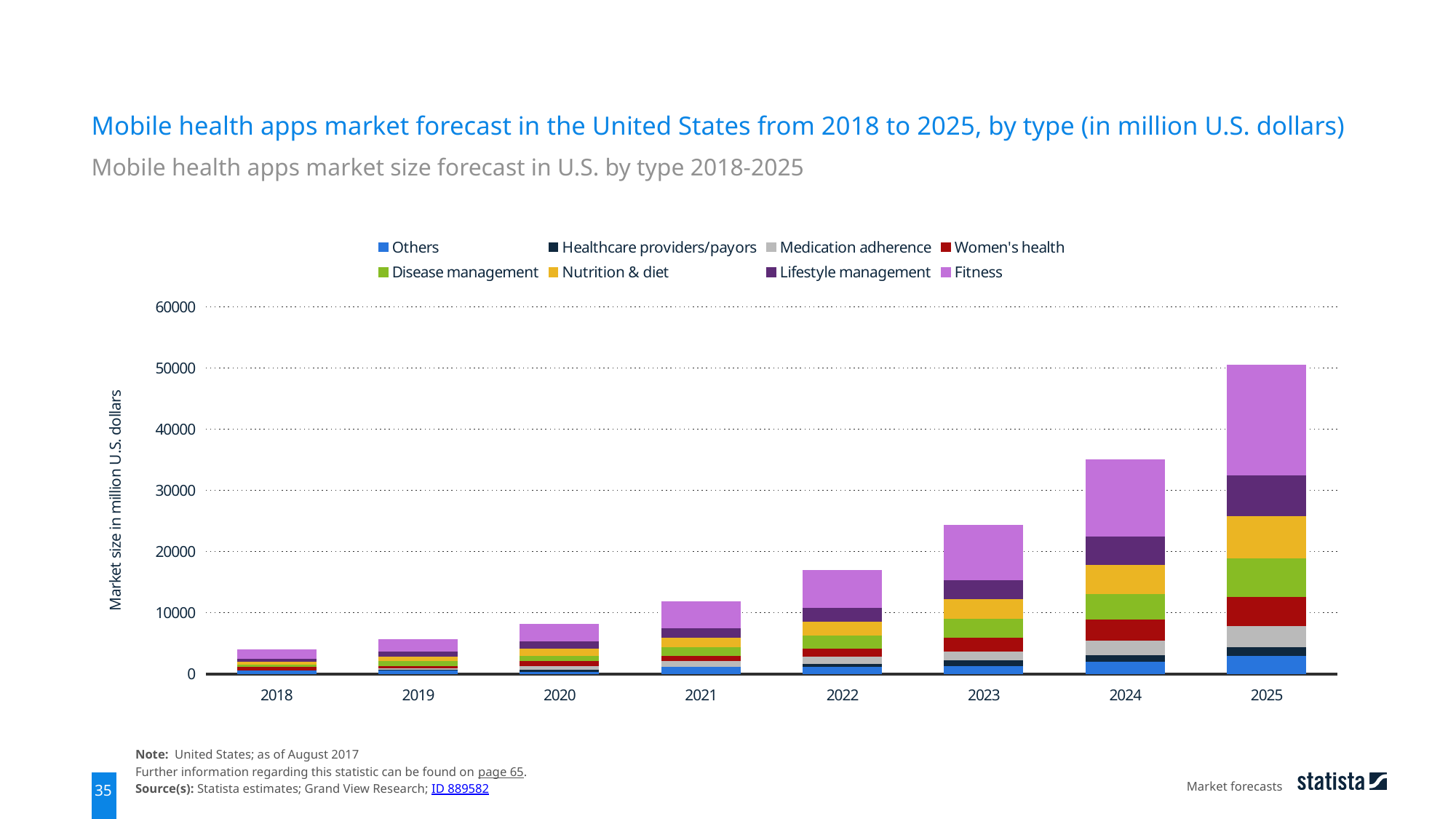
Is the total market size for 2025 greater or less than 40000? greater How many years are shown on the x axis of the chart? 8 Do the total market size values rise or fall from 2018 to 2025? Rise How many series does the legend list? 8 Which year has the larger total market size, 2023 or 2024? 2024 Is the total market size for 2022 greater or less than 20000? less Which year has the lowest total market size? 2018 What kind of chart is shown on the slide? Stacked bar chart Is the total market size for 2024 greater or less than 30000? greater Which year has the highest total market size? 2025 What is the label of the y axis? Market size in million U.S. dollars